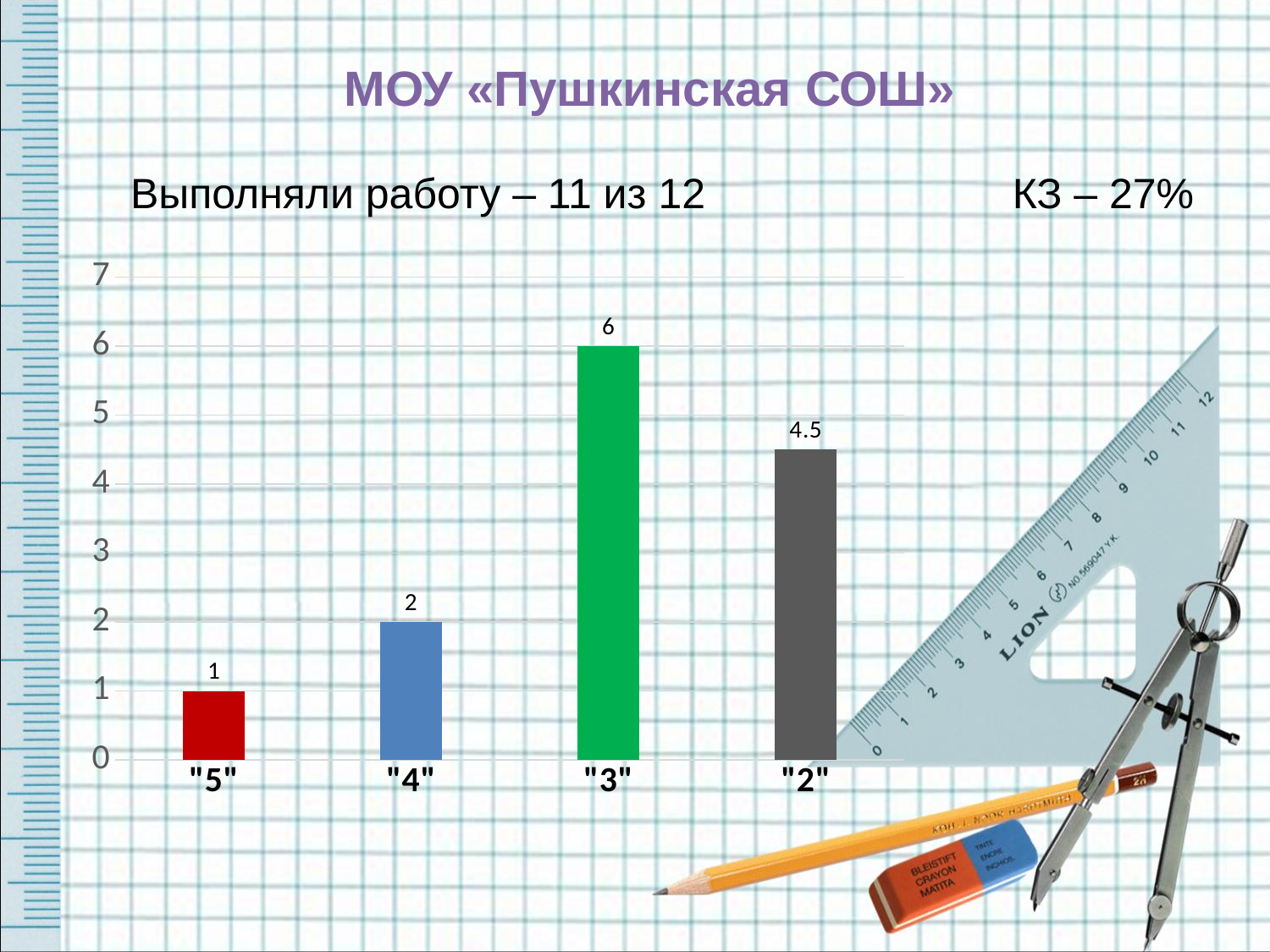
Which category has the highest value? "3" Which category has the lowest value? "5" What is the difference between the values for "3" and "2"? 1.5 Is the value for "2" greater or less than 4? greater What kind of chart is shown on the slide? bar chart What is the value for the "5" category? 1 What is the value for the "3" category? 6 Which is larger, the value for "4" or the value for "2"? "2" What is the value for the "2" category? 4.5 What colour is the bar for the "3" category? green What is the value for the "4" category? 2 How many categories are shown on the chart? 4